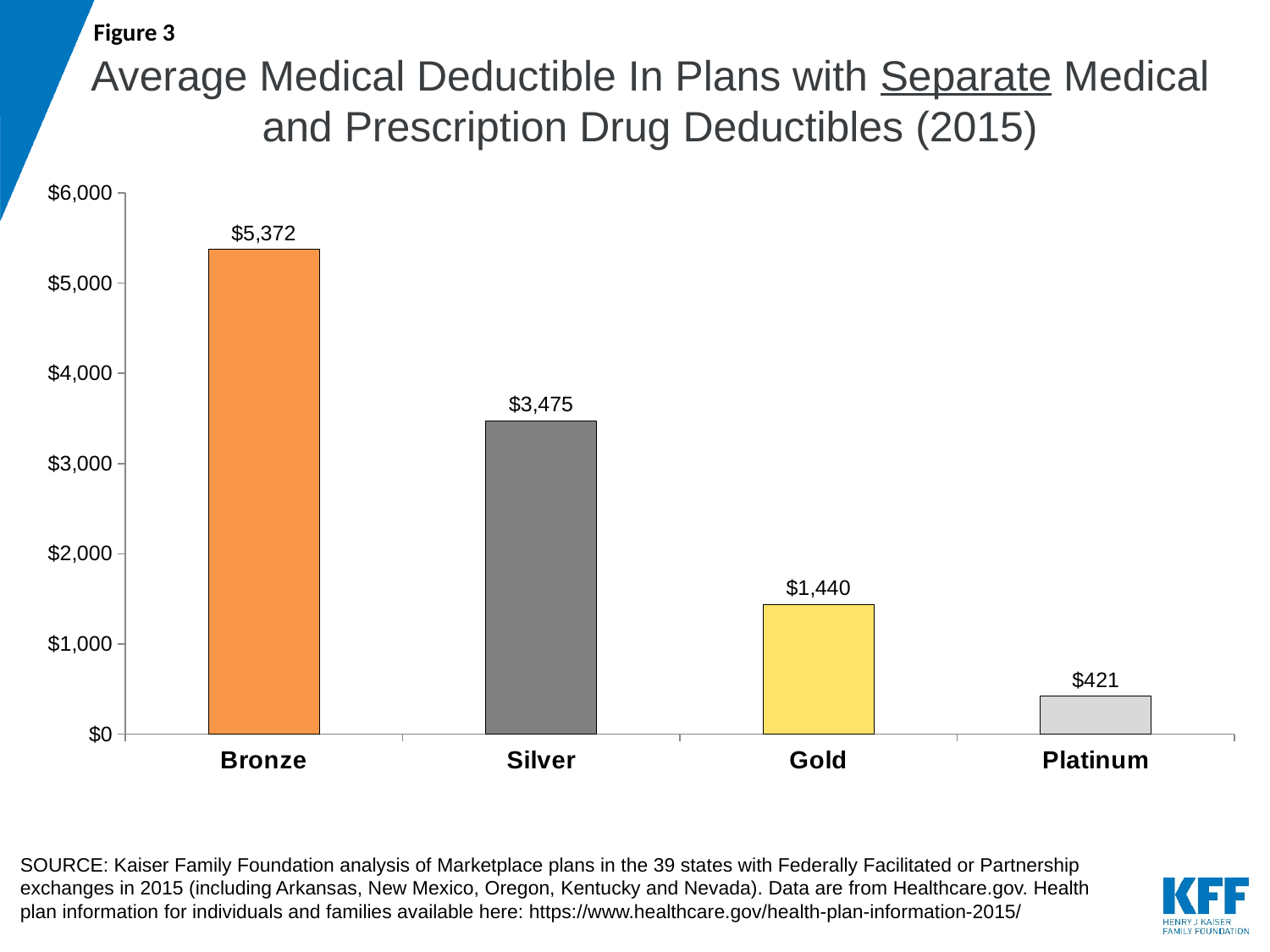
What is the average medical deductible for Bronze plans? $5,372 Which plan type has the lowest average medical deductible? Platinum How many plan types are shown in the chart? 4 Which has a larger average medical deductible, Silver or Gold? Silver What is the difference between the Bronze and Silver average medical deductibles? $1,897 What kind of chart is shown on the slide? Bar chart What is the difference between the Gold and Platinum average medical deductibles? $1,019 Which plan type has the highest average medical deductible? Bronze What is the average medical deductible for Gold plans? $1,440 Do the values rise or fall moving from Bronze to Platinum along the x axis? Fall What is the average medical deductible for Silver plans? $3,475 What is the average medical deductible for Platinum plans? $421